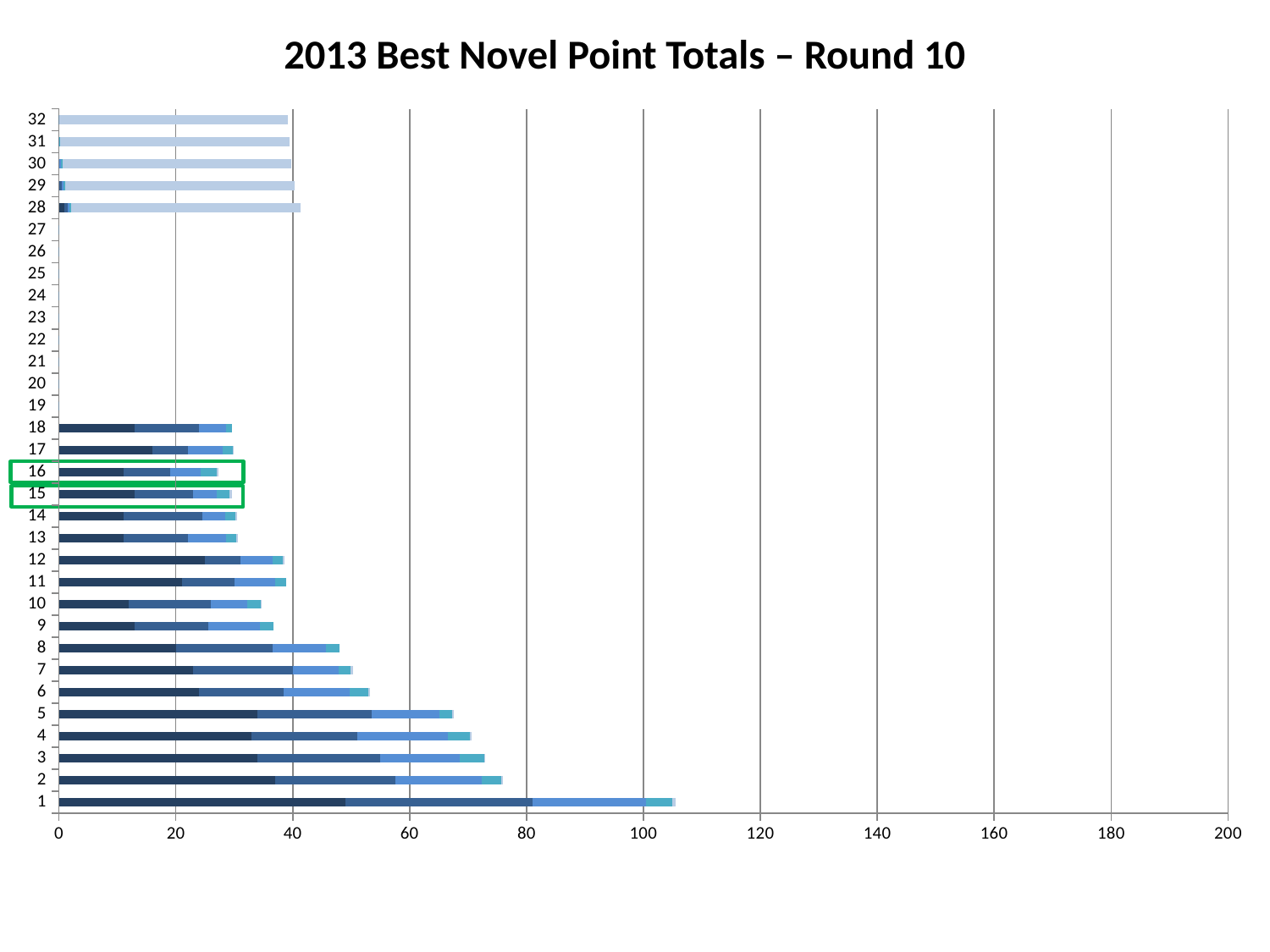
Which has the larger total, category 1 or category 2? 1 Which has the larger total, category 5 or category 8? 5 Is the total for category 18 greater or less than 40? less What is the maximum value shown on the horizontal axis? 200 Which category has the highest total in the chart? 1 Which two categories are highlighted with green boxes on the chart? 15 and 16 What is the title of the chart? 2013 Best Novel Point Totals – Round 10 Is the total for category 8 greater or less than 60? less How many categories are listed on the vertical axis of the chart? 32 Is the total for category 2 greater or less than 60? greater What kind of chart is shown on the slide? bar chart